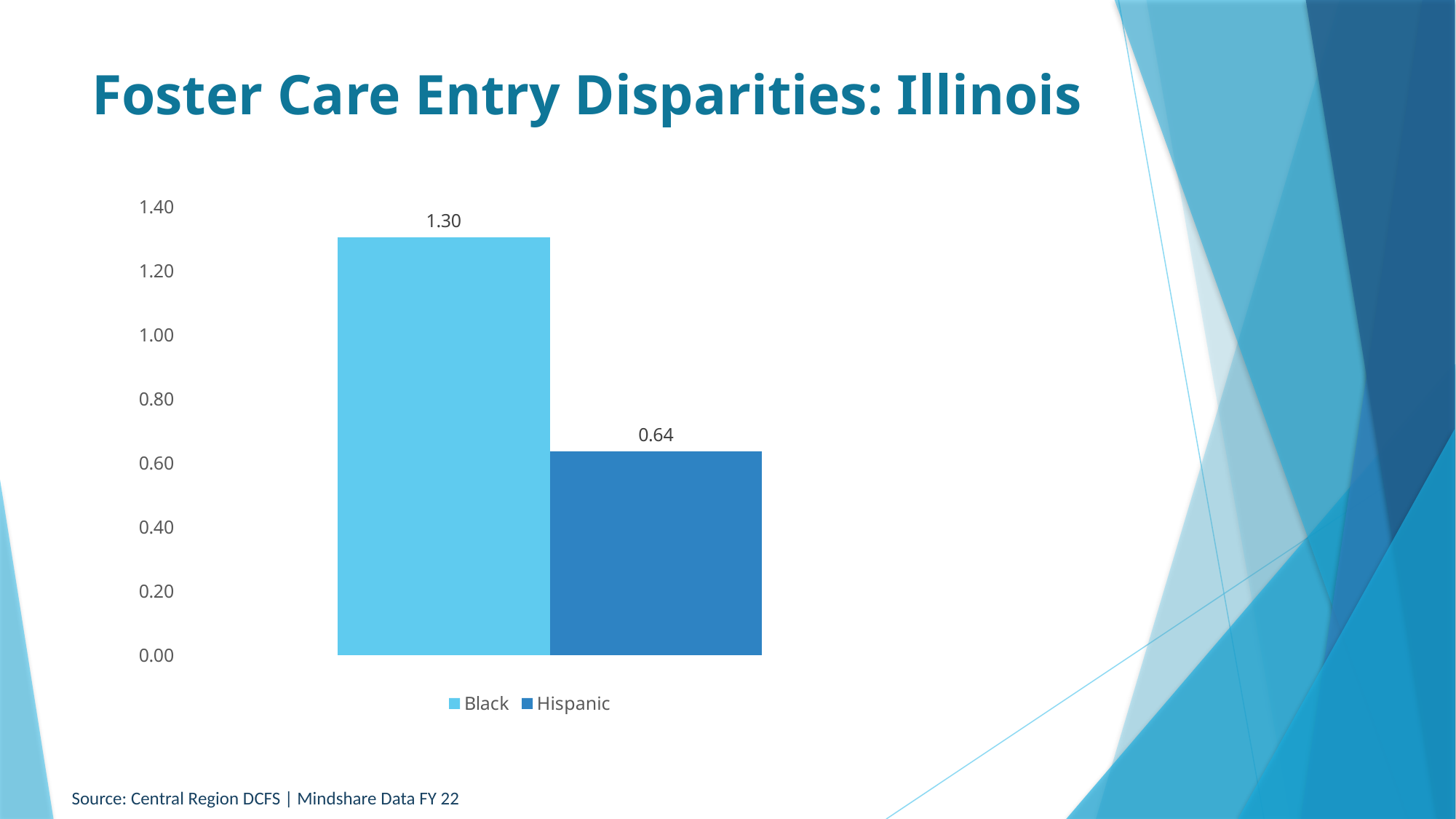
Is the value for Black greater or less than 1.20? greater Is the value for Hispanic greater or less than 0.80? less How many series does the legend list? 2 What is the value for Black? 1.30 Which series has the lowest value? Hispanic Which is larger, the value for Black or the value for Hispanic? Black What is the difference between the values for Black and Hispanic? 0.66 What is the value for Hispanic? 0.64 What is the title of the slide? Foster Care Entry Disparities: Illinois Which series has the highest value? Black What kind of chart is shown on the slide? bar chart What is the maximum value shown on the vertical axis? 1.40